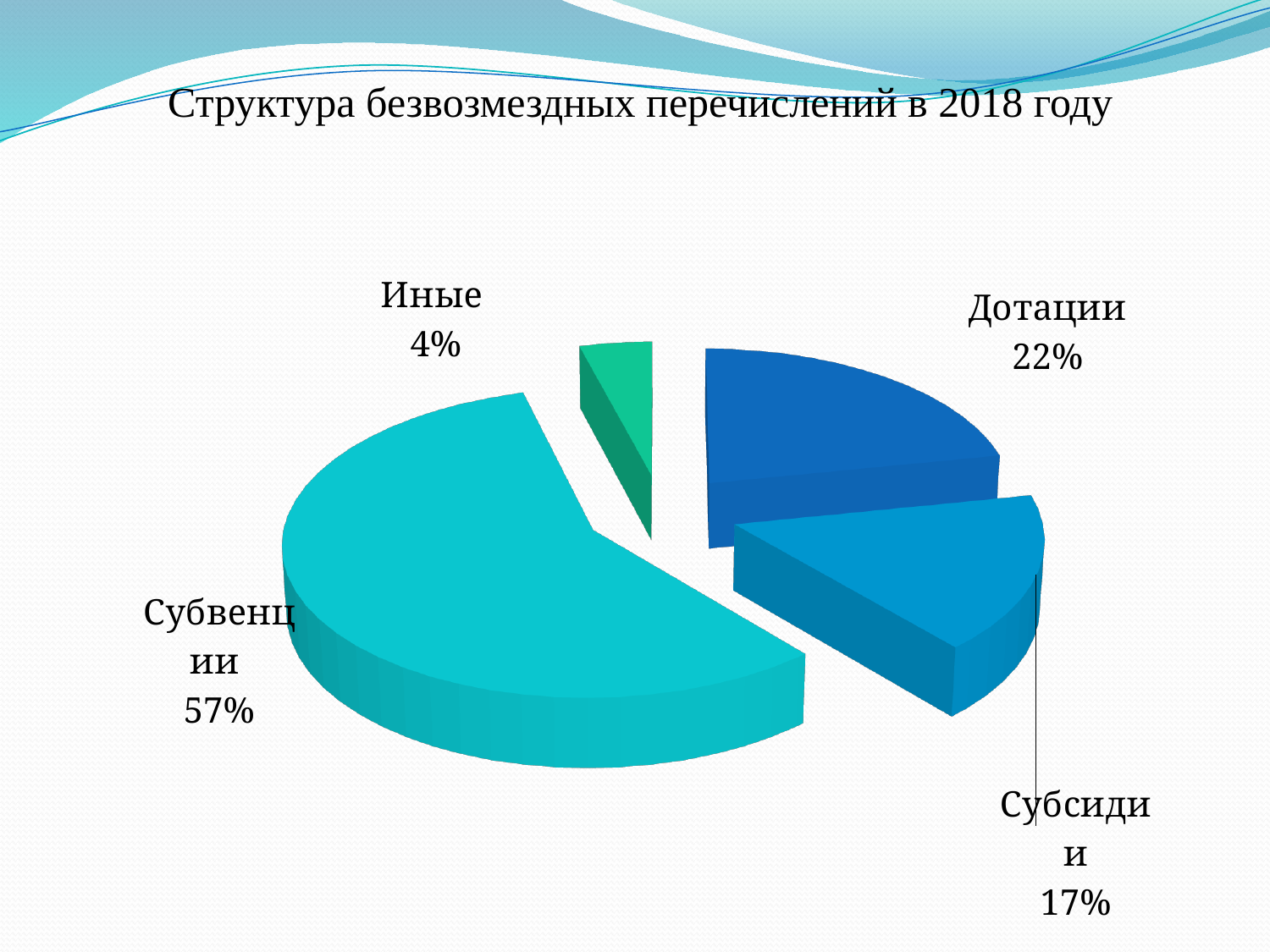
Which is larger, Дотации or Субсидии? Дотации How many slices does the pie chart have? 4 What kind of chart is shown on the slide? Pie chart What is the difference in percentage points between Субвенции and Дотации? 35% Which category has the smallest share of the pie? Иные What is the difference in percentage points between Дотации and Субсидии? 5% What share of the pie does Иные have? 4% What share of the pie does Субвенции have? 57% What share of the pie does Дотации have? 22% What is the title of the chart? Структура безвозмездных перечислений в 2018 году Which category has the largest share of the pie? Субвенции